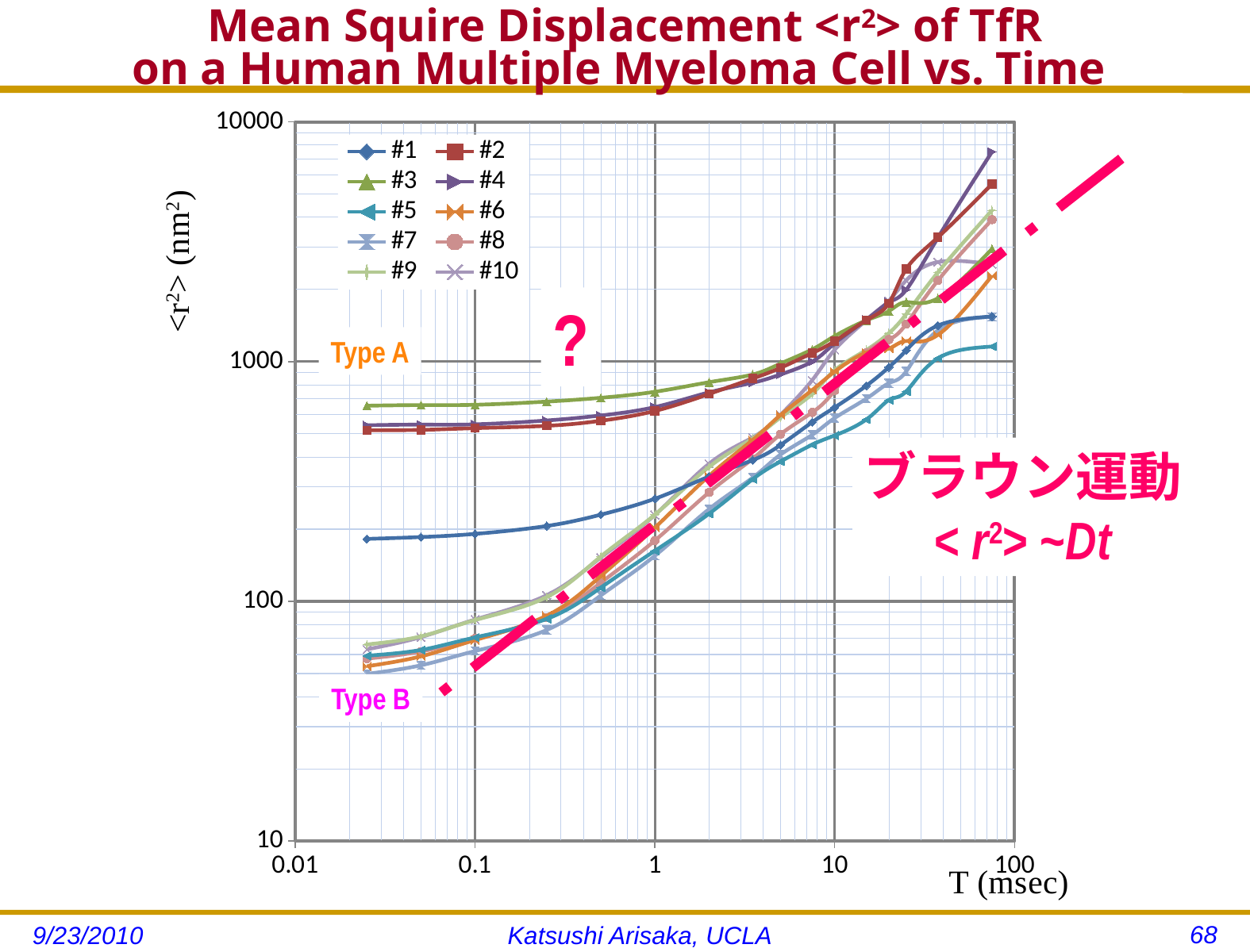
Is the value for series #4 at its last plotted point (near T = 80 msec) greater or less than 1000? greater Do the plotted values generally rise or fall as T increases along the x axis? rise What is the label of the y axis? <r²> (nm²) Is the value for series #3 at T = 0.1 msec greater or less than 100? greater How many series does the legend list? 10 What is the label of the x axis? T (msec) Is the value for series #2 at T = 1 msec greater or less than 1000? less What kind of chart is shown on the slide? line chart At T = 0.1 msec, which series has the larger value, #3 or #5? #3 Which series reaches the highest value at the right end of the chart? #4 At T = 0.1 msec, which series has the larger value, #1 or #2? #2